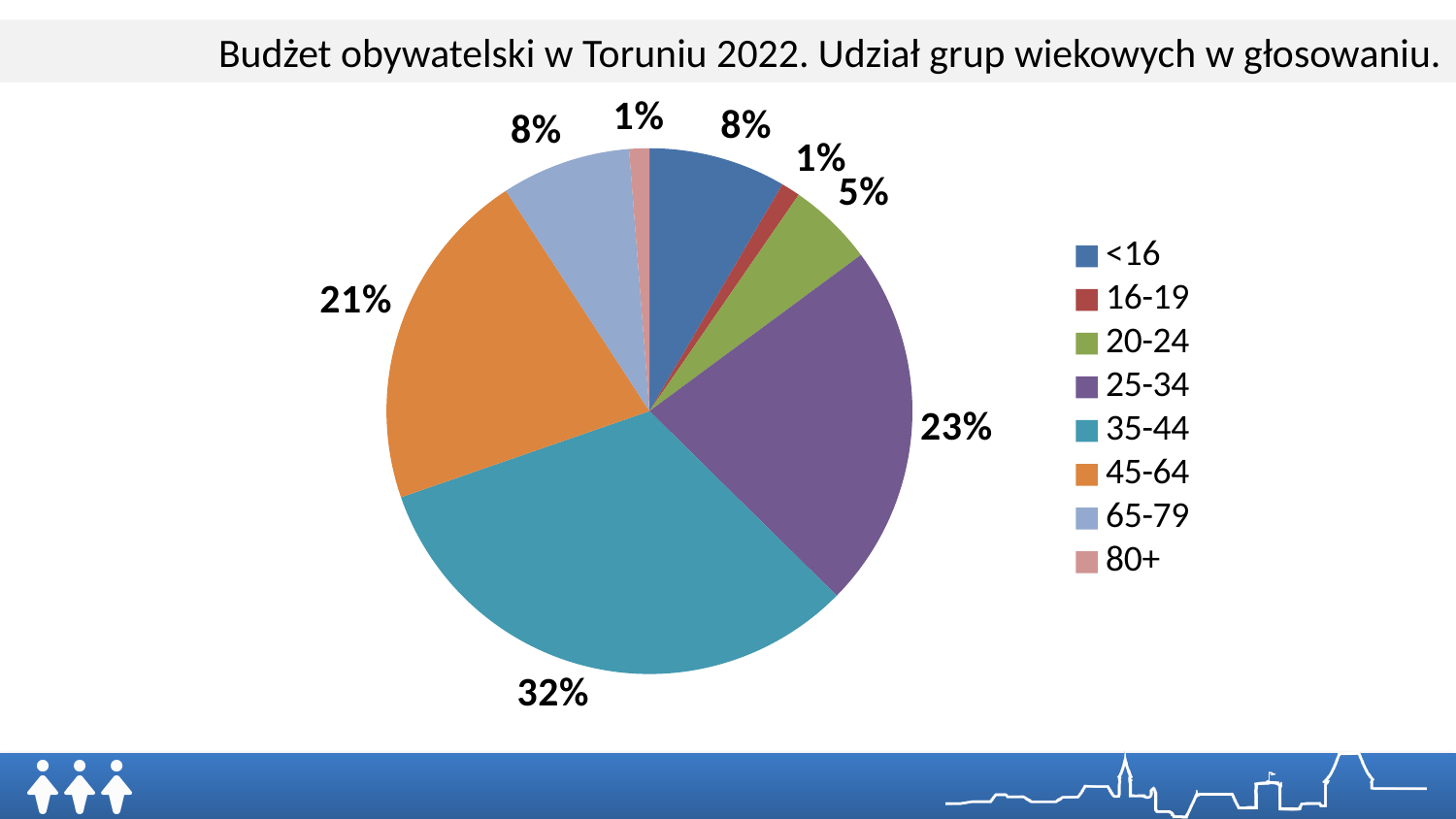
What share of the vote does the 45-64 age group have? 21% What share of the vote does the <16 age group have? 8% What share of the vote does the 25-34 age group have? 23% What is the title of the chart? Budżet obywatelski w Toruniu 2022. Udział grup wiekowych w głosowaniu. What kind of chart is shown on the slide? Pie chart Which has a larger share, the 45-64 group or the 25-34 group? 25-34 What is the difference in share between the 35-44 and 25-34 age groups? 9 percentage points How many age groups are shown in the pie chart? 8 Which age group has the largest share of the vote? 35-44 What colour is the slice for the 45-64 age group? Orange